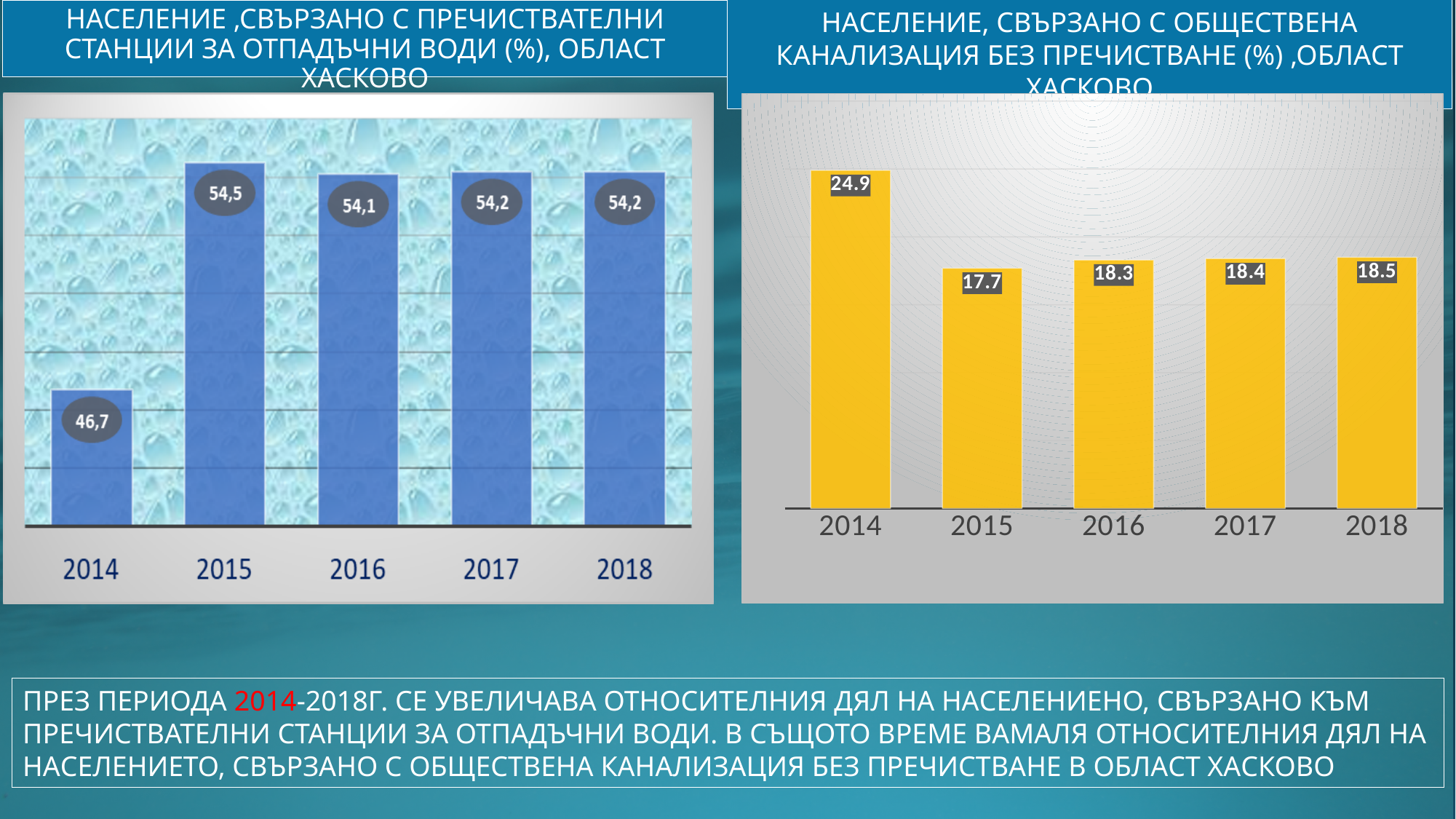
In the left chart (population connected to wastewater treatment plants), which year has the highest value? 2015 In the right chart (population connected to public sewerage without treatment), what is the difference between the 2014 value and the 2015 value? 7.2 What type of chart is the right chart (population connected to public sewerage without treatment)? Bar chart What colour are the bars in the left chart (population connected to wastewater treatment plants)? Blue In the left chart (population connected to wastewater treatment plants), what is the value for 2014? 46,7 In the right chart (population connected to public sewerage without treatment), what is the value for 2014? 24.9 In the left chart (population connected to wastewater treatment plants), how many years are shown? 5 In the right chart (population connected to public sewerage without treatment), which is larger, the value for 2014 or the value for 2016? 2014 In the left chart (population connected to wastewater treatment plants), which year has the lowest value? 2014 In the right chart (population connected to public sewerage without treatment), which year has the lowest value? 2015 In the right chart (population connected to public sewerage without treatment), what is the value for 2018? 18.5 In the left chart (population connected to wastewater treatment plants), what is the difference between the 2015 value and the 2014 value? 7,8